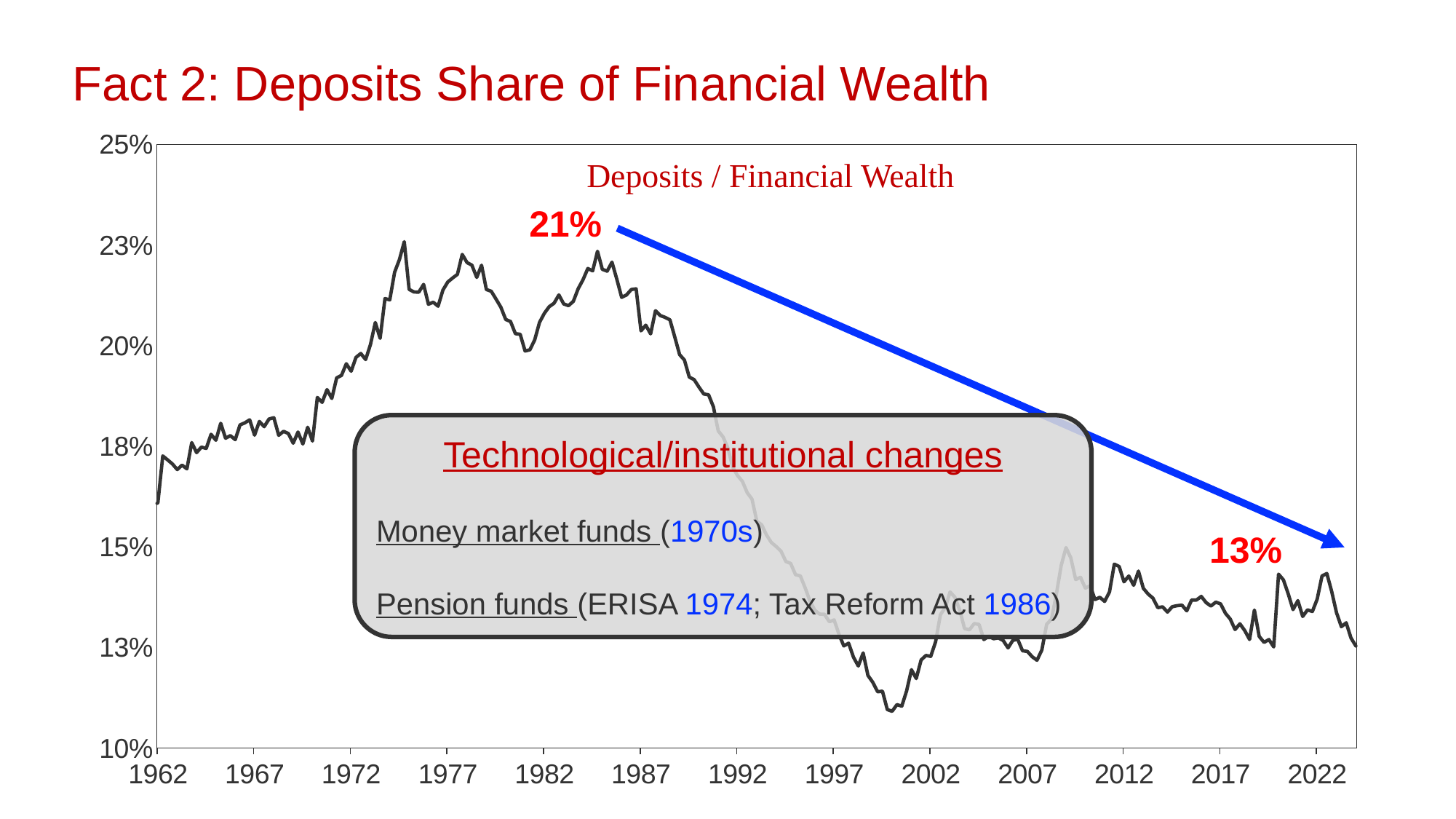
Is the value around 2000 greater or less than 13%? less What is the highest value shown on the y axis? 25% What is the title printed inside the chart area? Deposits / Financial Wealth What value is annotated in red at the start of the blue arrow? 21% Is the value around 2022 greater or less than 18%? less What kind of chart is shown on the slide? line chart What value is annotated in red at the end of the blue arrow? 13% Is the value for 1962 greater or less than 18%? less Overall, does the deposits share of financial wealth rise or fall from 1962 to 2022? fall How many year labels are shown on the x axis? 13 By how many percentage points do the two annotated values (21% and 13%) differ? 8 percentage points